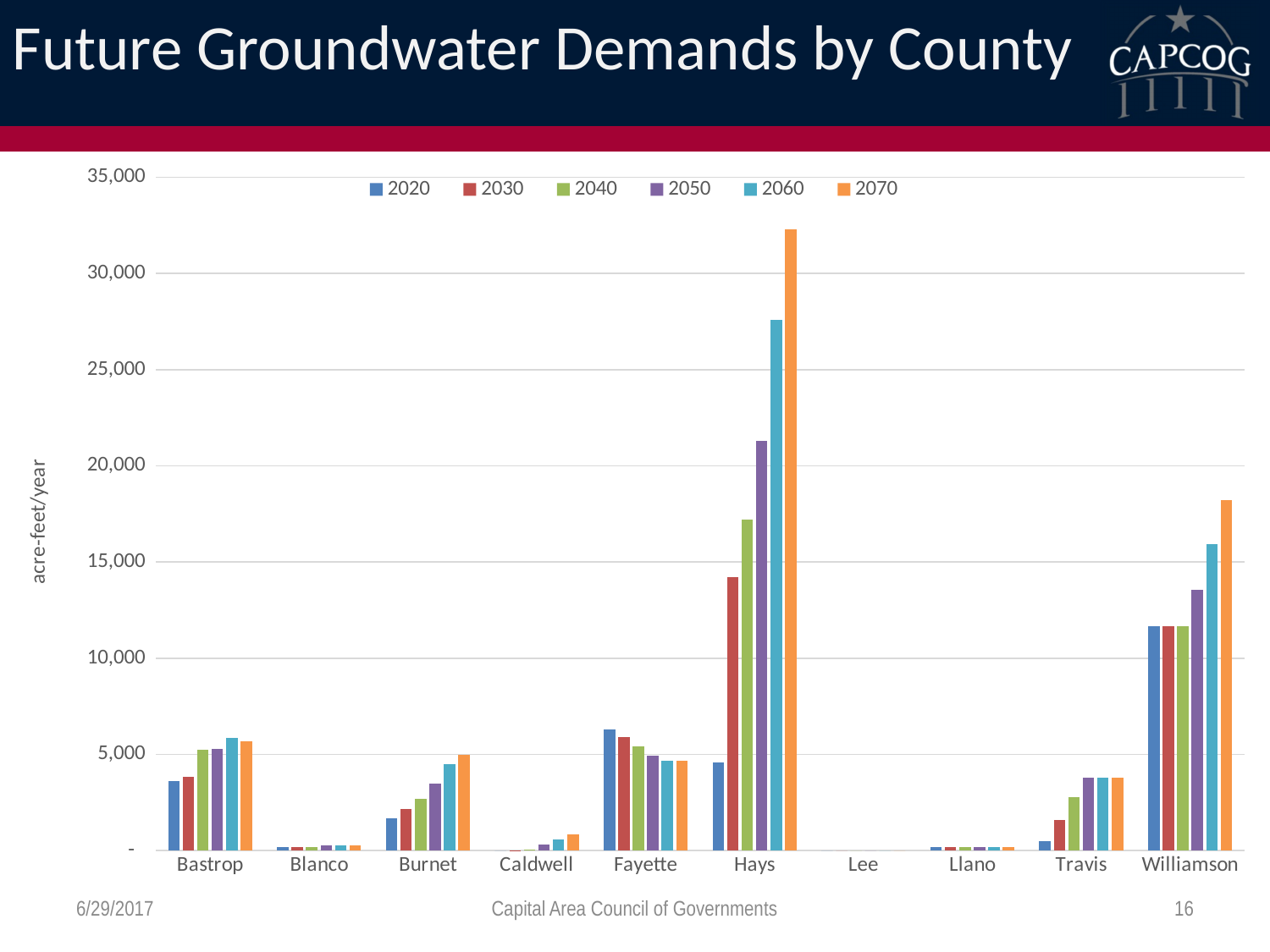
Is the 2020 value for Fayette greater or less than 5,000? greater Is the 2070 value for Hays greater or less than 30,000? greater Which county has the highest groundwater demand in 2070? Hays What kind of chart is shown on the slide? bar chart Is the 2070 value for Williamson greater or less than 15,000? greater What unit is shown on the y axis label? acre-feet/year Do the values for Hays rise or fall from 2020 to 2070? rise Which is larger, the 2070 value for Williamson or the 2070 value for Hays? Hays How many counties are shown along the x axis? 10 How many series does the legend list? 6